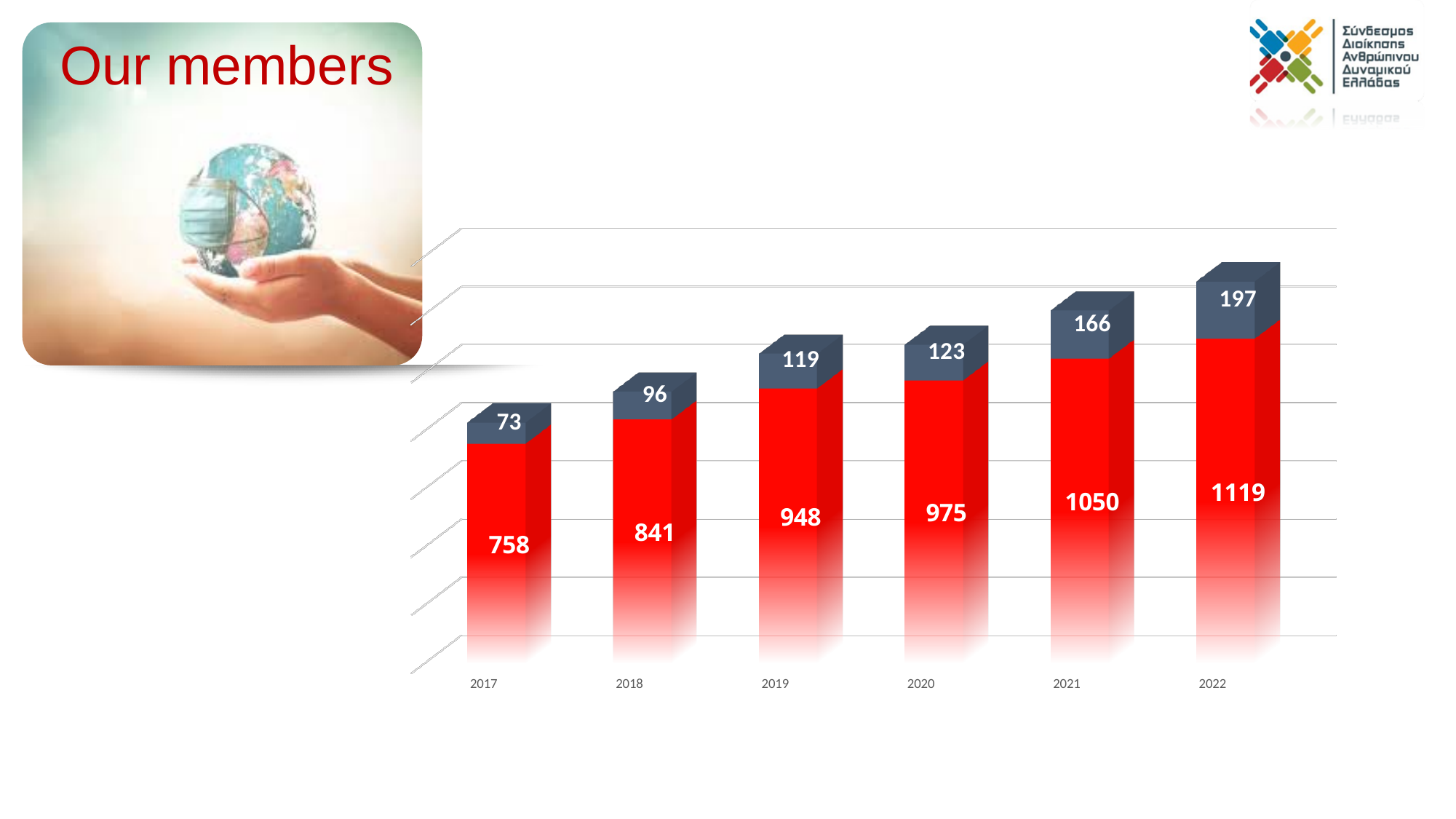
What is the difference between the dark blue segment values for 2020 and 2019? 4 What is the value of the red segment for 2019? 948 How many years are shown on the x axis? 6 What is the value of the dark blue segment for 2021? 166 Which year has the lowest value for the dark blue segment? 2017 What type of chart is shown on the slide? bar chart Which year has the highest value for the red segment? 2022 What is the value of the red segment for 2017? 758 What is the difference between the red segment values for 2022 and 2021? 69 Do the red segment values rise or fall from 2017 to 2022? rise Which is larger, the red segment for 2018 or the red segment for 2020? 2020 What is the total of the stacked bar for 2022? 1316